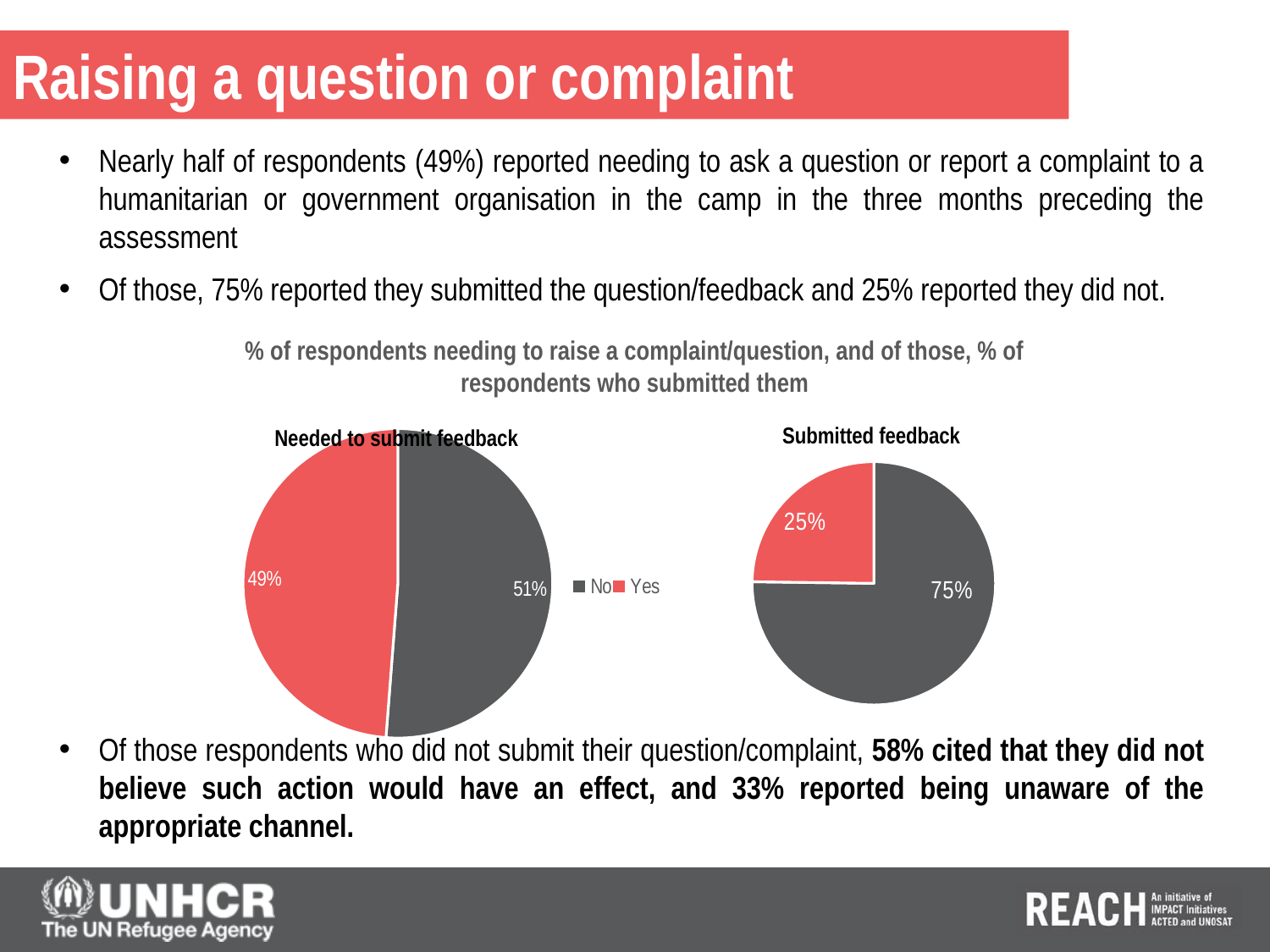
How many pie charts are on the slide? 2 In the 'Needed to submit feedback' pie chart, what is the difference between the No and Yes slices? 2% In the 'Needed to submit feedback' pie chart, which slice is larger, Yes or No? No In the 'Submitted feedback' pie chart, what is the value of the largest slice? 75% What is the title of the pie chart on the right? Submitted feedback In the 'Submitted feedback' pie chart, what is the value of the smallest slice? 25% In the 'Needed to submit feedback' pie chart, what percentage is shown for No? 51% In the 'Submitted feedback' pie chart, what is the difference between the two slices? 50% What kind of charts are shown on the slide? Pie charts In the 'Needed to submit feedback' pie chart, what percentage is shown for Yes? 49% How many entries does the legend list? 2 Which colour represents 'Yes' in the legend? Red